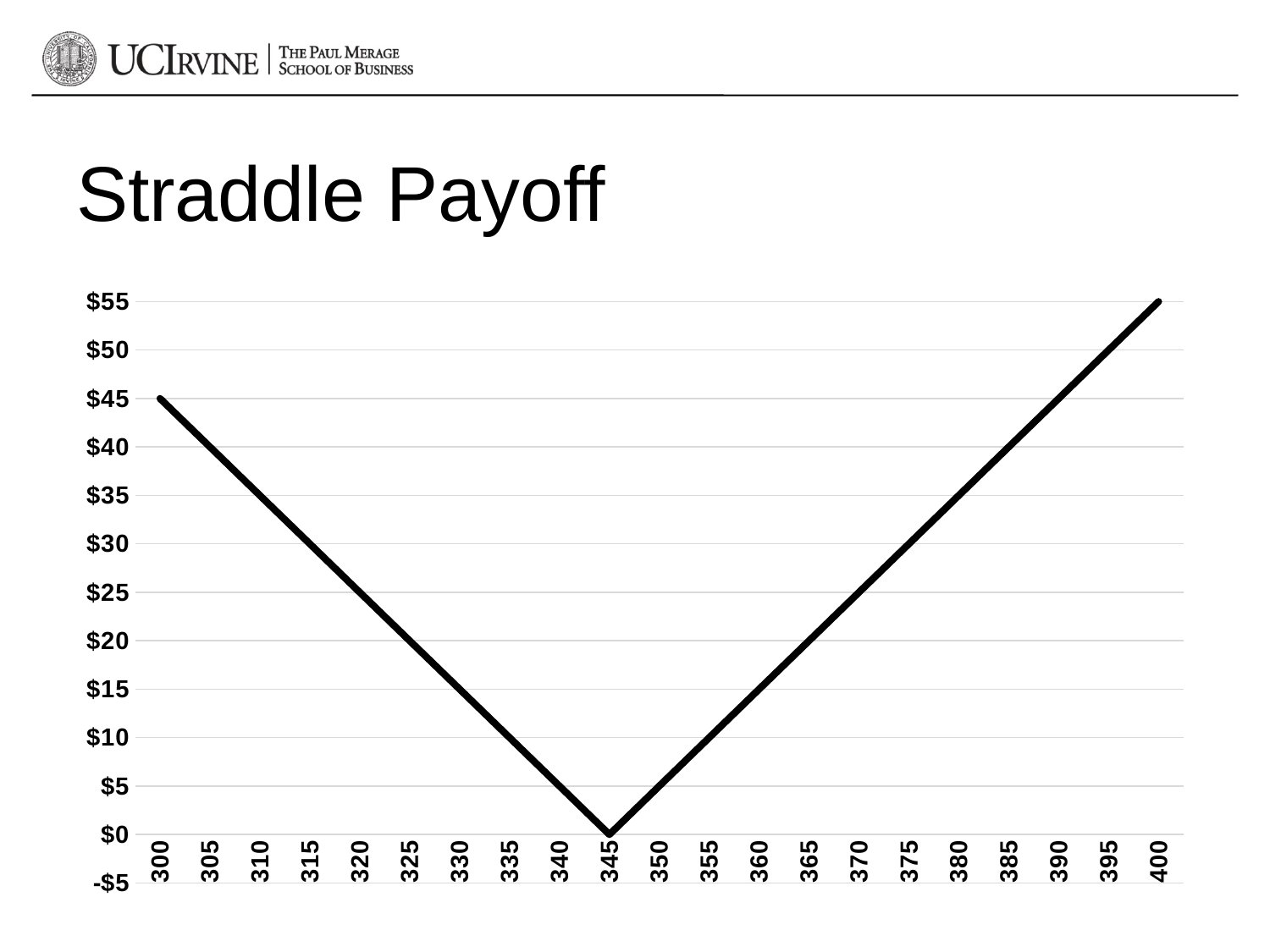
How does the payoff change as the price moves from 300 to 400? It falls to $0 at 345, then rises Which has the larger payoff, a price of 300 or a price of 400? 400 What is the title of the chart? Straddle Payoff What is the payoff value at a price of 345? $0 What is the payoff value at a price of 400? $55 What kind of chart is shown on the slide? line chart What is the payoff value at a price of 300? $45 What is the difference between the payoff at 400 and the payoff at 300? $10 At which price on the x axis is the payoff highest? 400 Is the payoff at a price of 310 greater or less than $30? greater At which price on the x axis is the payoff lowest? 345 How many price points are labelled on the x axis? 21